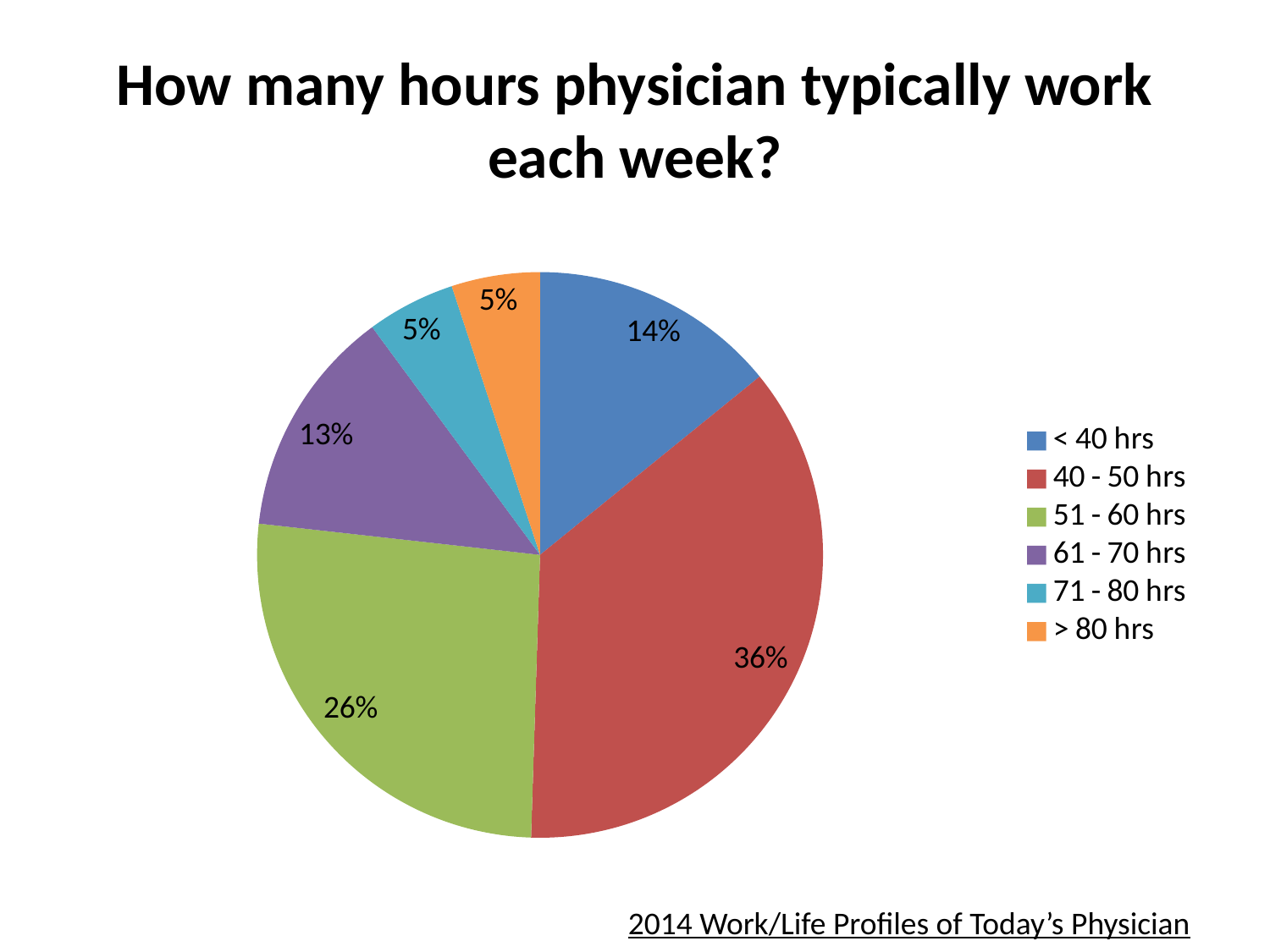
How many categories does the pie chart show? 6 What share of physicians work 61 - 70 hrs each week? 13% What share of physicians work < 40 hrs each week? 14% What share of physicians work 51 - 60 hrs each week? 26% What is the title of the chart? How many hours physician typically work each week? What is the combined share of the 71 - 80 hrs and > 80 hrs slices? 10% What is the difference in percentage points between the 40 - 50 hrs slice and the 51 - 60 hrs slice? 10 Which is larger, the share for < 40 hrs or the share for 61 - 70 hrs? < 40 hrs What kind of chart is shown on the slide? Pie chart What share of physicians work 40 - 50 hrs each week? 36% Which category has the largest share of the pie? 40 - 50 hrs What colour is the slice for 51 - 60 hrs? Green